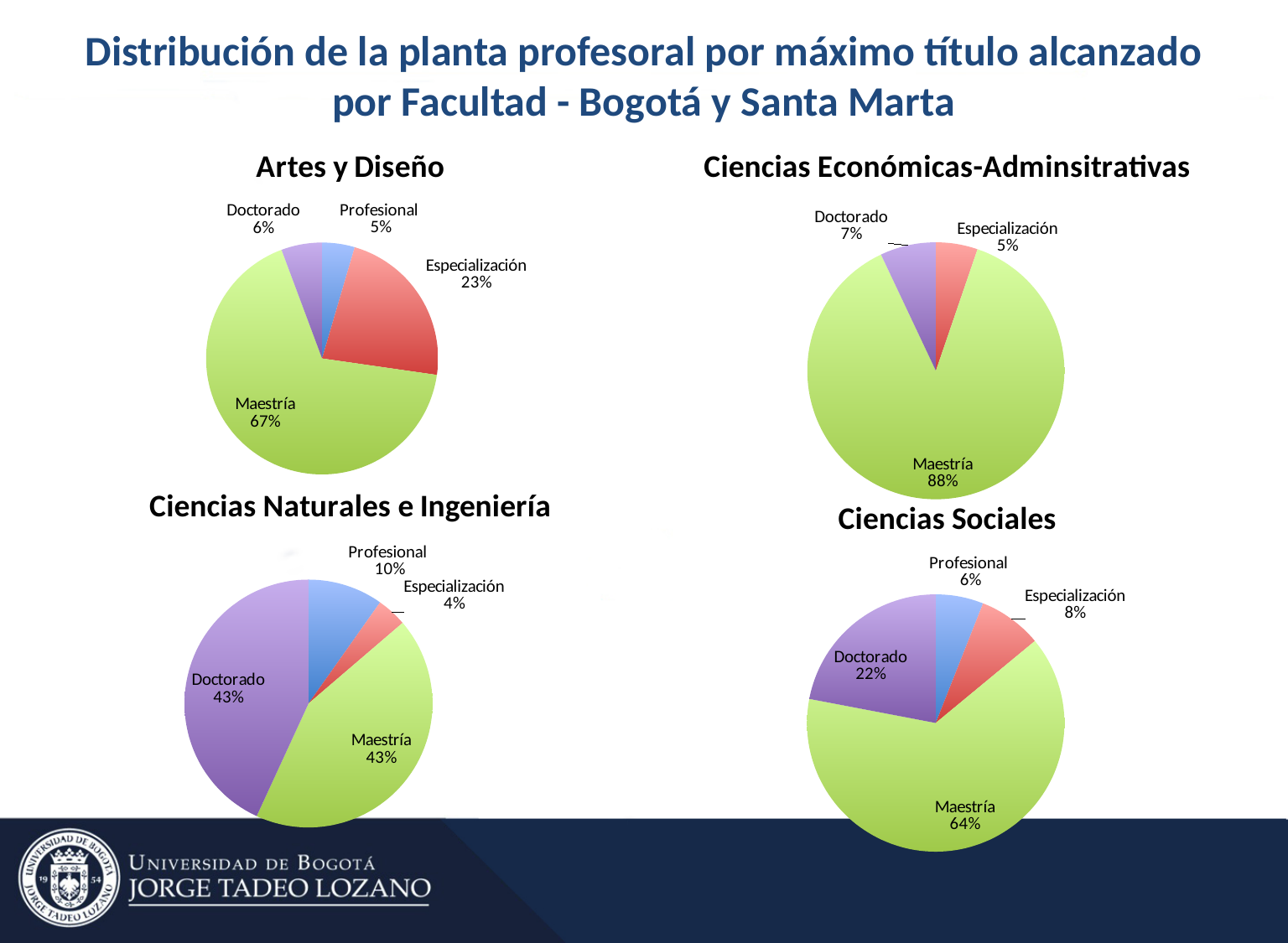
In the Ciencias Naturales e Ingeniería chart, which category has the smallest slice? Especialización In the Artes y Diseño chart, what share of the faculty holds a Maestría? 67% In the Ciencias Económicas-Adminsitrativas chart, what is the value for Maestría? 88% In the Artes y Diseño chart, which is larger, Doctorado or Especialización? Especialización How many pie charts are shown on the slide? 4 In the Artes y Diseño chart, what is the value for Especialización? 23% In the Ciencias Sociales chart, what is the value for Doctorado? 22% In the Ciencias Sociales chart, which category has the largest slice? Maestría In the Ciencias Naturales e Ingeniería chart, what is the value for Doctorado? 43% What type of chart is used for Ciencias Sociales? Pie chart In the Ciencias Económicas-Adminsitrativas chart, how many slices does the pie have? 3 In the Ciencias Sociales chart, what is the difference between Maestría and Doctorado? 42%